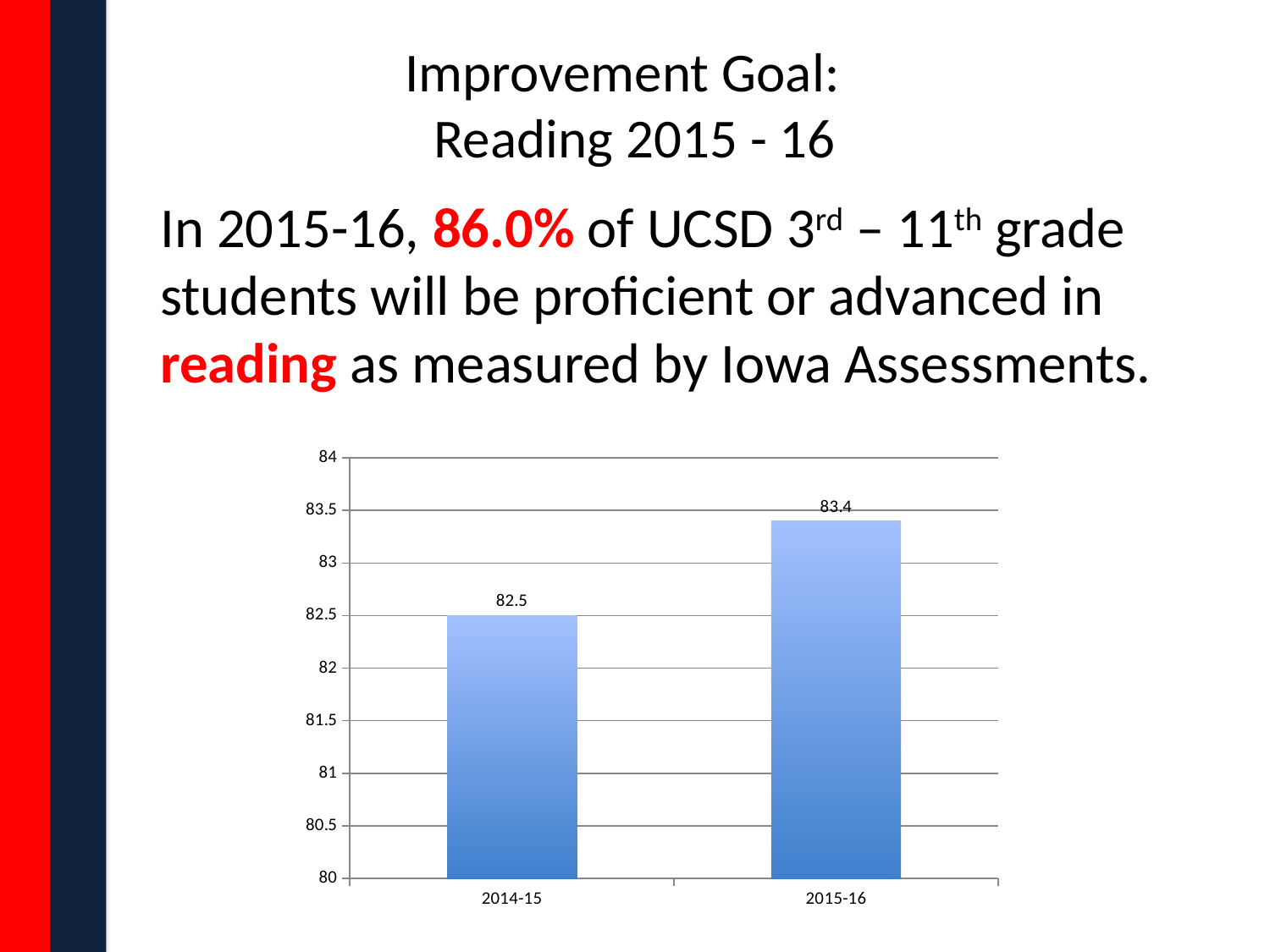
How many categories are shown on the x axis? 2 Which is larger, the value for 2014-15 or the value for 2015-16? 2015-16 What is the lowest value shown on the y axis? 80 What is the value for 2015-16? 83.4 Is the value for 2014-15 greater or less than 83? less Do the values rise or fall from 2014-15 to 2015-16? rise What is the value for 2014-15? 82.5 What is the difference between the values for 2015-16 and 2014-15? 0.9 Is the value for 2015-16 greater or less than 83? greater What kind of chart is shown on the slide? bar chart Which category has the lowest value? 2014-15 Which category has the highest value? 2015-16